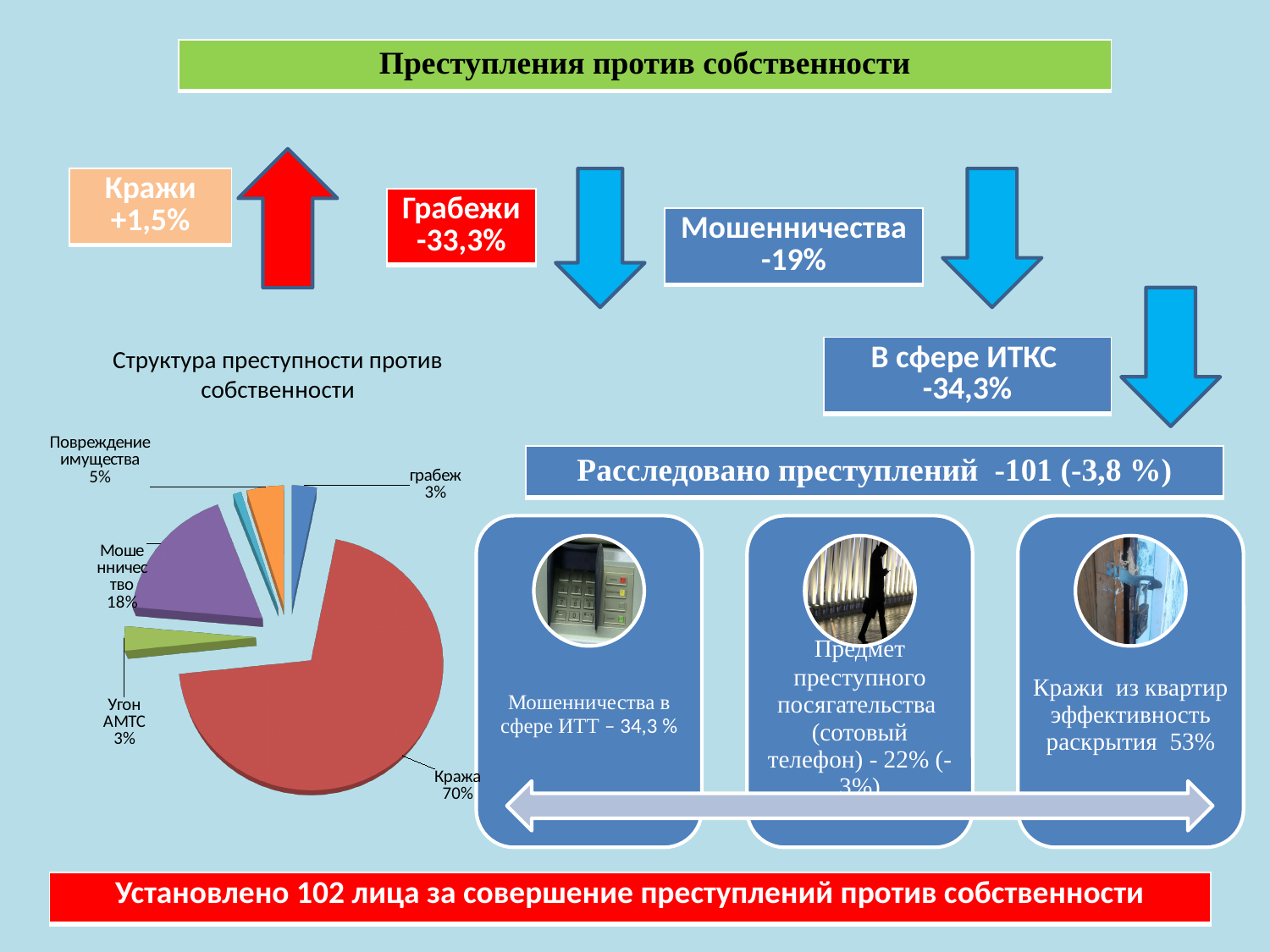
What is the title of the pie chart on the slide? Структура преступности против собственности In the pie chart, what percentage is shown for "Повреждение имущества"? 5% In the pie chart, which is larger: "Мошенничество" or "Повреждение имущества"? Мошенничество In the pie chart, what is the difference in percentage points between "Кража" and "Мошенничество"? 52 Which category has the largest slice in the pie chart? Кража In the pie chart, is the share for "Кража" greater or less than 50%? greater In the pie chart, what share does "Кража" have? 70% What colour is the "Кража" slice in the pie chart? red In the pie chart, what percentage is shown for "Мошенничество"? 18% In the pie chart, what percentage is shown for "грабеж"? 3% What kind of chart is shown under the heading "Структура преступности против собственности"? pie chart In the pie chart, what percentage is shown for "Угон АМТС"? 3%